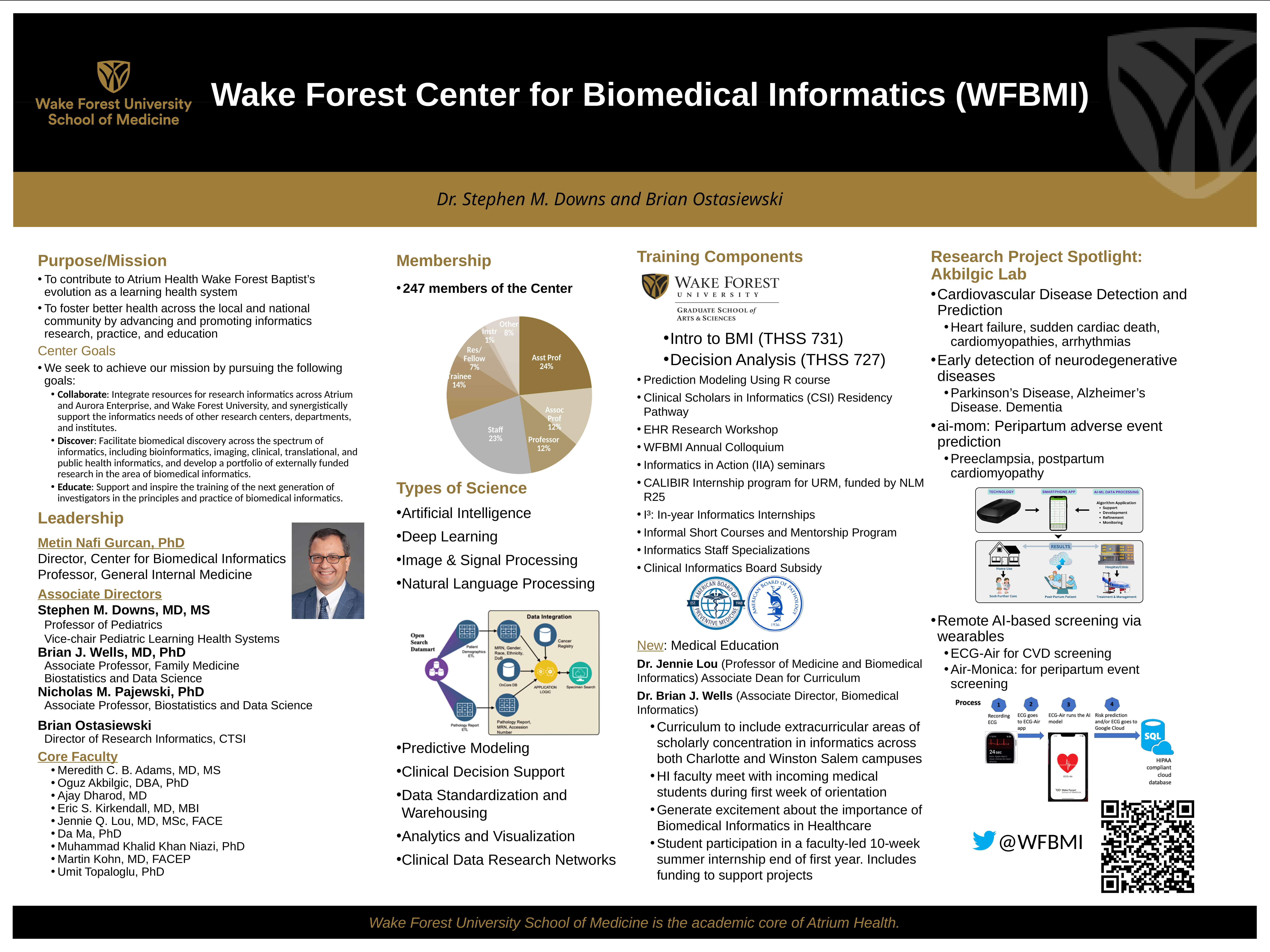
In the Membership pie chart, what share of members are Trainees? 14% What kind of chart is shown in the Membership section? pie chart In the Membership pie chart, which category has the largest share? Asst Prof In the Membership pie chart, which is larger: the Trainee share or the Other share? Trainee In the Membership pie chart, which category has the smallest share? Instr According to the Membership section, how many members does the Center have? 247 In the Membership pie chart, how many categories (slices) are shown? 8 In the Membership pie chart, what share of members are Staff? 23% In the Membership pie chart, what share of members are Instr? 1% In the Membership pie chart, what share of members are Asst Prof? 24% In the Membership pie chart, what share of members are Res/Fellow? 7% In the Membership pie chart, what is the difference in percentage points between Asst Prof and Assoc Prof? 12